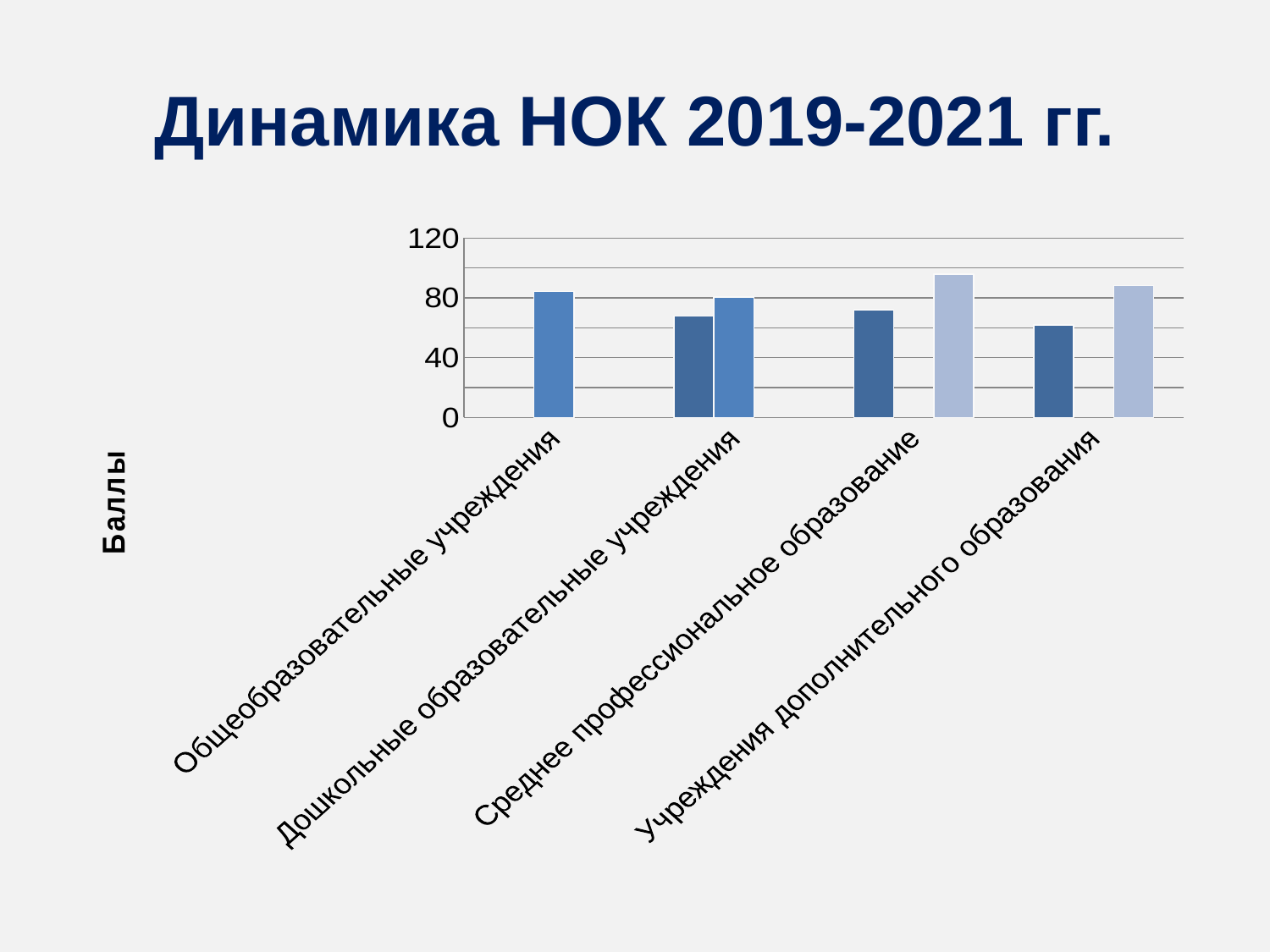
Is the value of the dark blue bar for Среднее профессиональное образование greater or less than 80? less Is the value of the light blue bar for Среднее профессиональное образование greater or less than 80? greater For Дошкольные образовательные учреждения, which bar is taller: the dark blue bar or the medium blue bar? the medium blue bar Which light blue bar is taller: the one for Среднее профессиональное образование or the one for Учреждения дополнительного образования? Среднее профессиональное образование Is the value of the dark blue bar for Учреждения дополнительного образования greater or less than 80? less What is the title of the chart on the slide? Динамика НОК 2019-2021 гг. How many bars are plotted in the chart in total? 7 What is the label of the vertical axis of the chart? Баллы What type of chart is shown on the slide? bar chart How many categories are shown on the x axis of the chart? 4 Which category contains the tallest bar in the chart? Среднее профессиональное образование